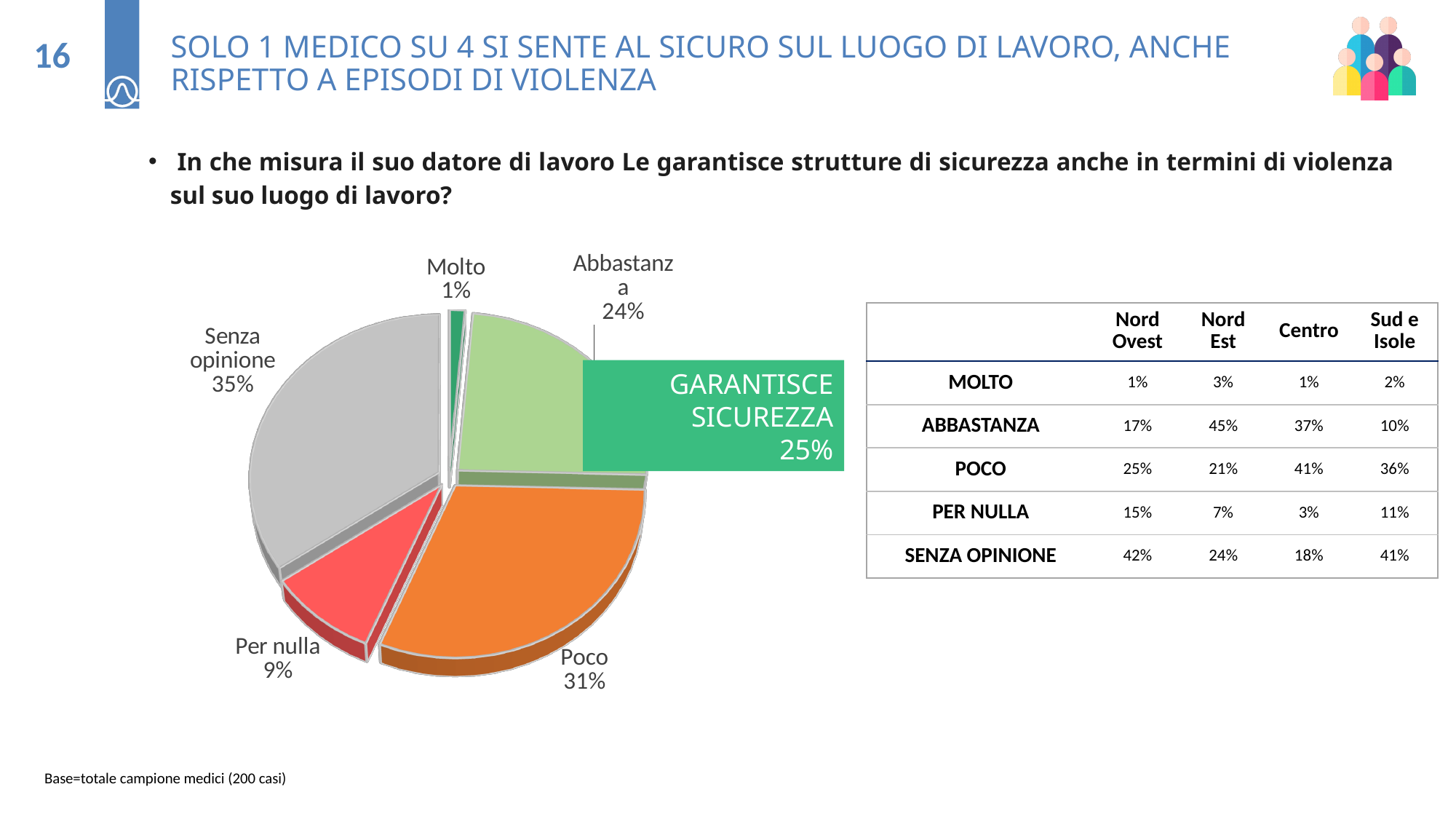
Which is larger in the pie chart, "Per nulla" or "Abbastanza"? Abbastanza Which slice of the pie chart is the smallest? Molto What is the value for the "Senza opinione" slice of the pie chart? 35% How many slices does the pie chart have? 5 What is the value for the "Poco" slice of the pie chart? 31% What is the value for the "Molto" slice of the pie chart? 1% What is the difference between the "Poco" and "Abbastanza" slices of the pie chart? 7% What is the combined share of the "Molto" and "Abbastanza" slices, as shown in the green callout on the pie chart? 25% What text appears in the green callout box next to the pie chart? GARANTISCE SICUREZZA 25% What is the value for the "Per nulla" slice of the pie chart? 9% Which slice of the pie chart is the largest? Senza opinione What kind of chart is shown on the slide? Pie chart